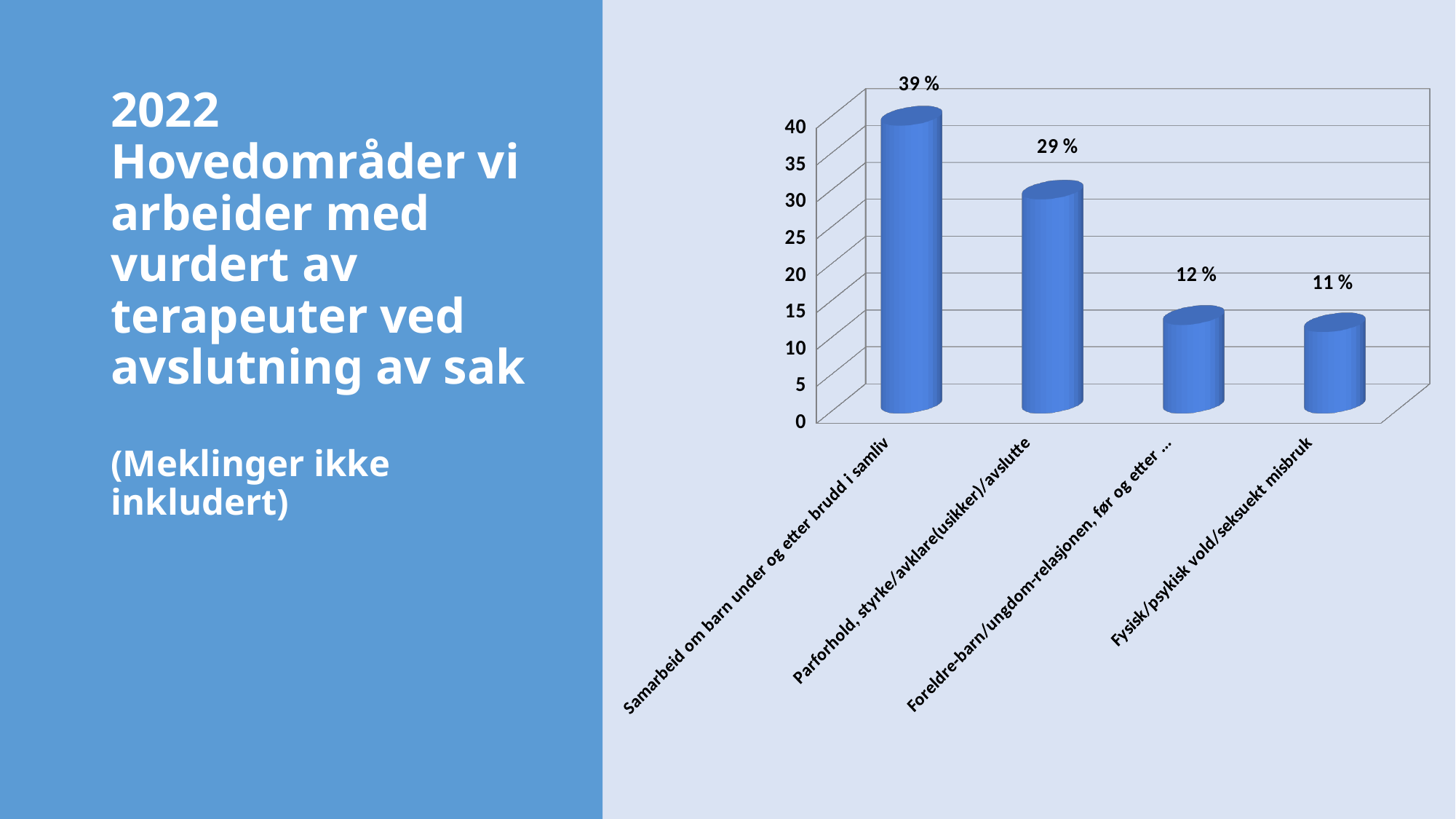
Do the values rise or fall from left to right along the x axis? Fall What is the difference between the values for "Parforhold, styrke/avklare(usikker)/avslutte" and "Fysisk/psykisk vold/seksuekt misbruk"? 18 % How many categories are shown in the chart? 4 What is the value for "Parforhold, styrke/avklare(usikker)/avslutte"? 29 % What kind of chart is shown on the slide? Bar chart What is the value for "Fysisk/psykisk vold/seksuekt misbruk"? 11 % Which category has the highest value? Samarbeid om barn under og etter brudd i samliv Which is larger: the value for "Parforhold, styrke/avklare(usikker)/avslutte" or the value for "Foreldre-barn/ungdom-relasjonen, før og etter ..."? Parforhold, styrke/avklare(usikker)/avslutte Which category has the lowest value? Fysisk/psykisk vold/seksuekt misbruk What is the difference between the values for "Samarbeid om barn under og etter brudd i samliv" and "Parforhold, styrke/avklare(usikker)/avslutte"? 10 % What is the value for "Samarbeid om barn under og etter brudd i samliv"? 39 % What is the value for the category "Foreldre-barn/ungdom-relasjonen, før og etter ..."? 12 %